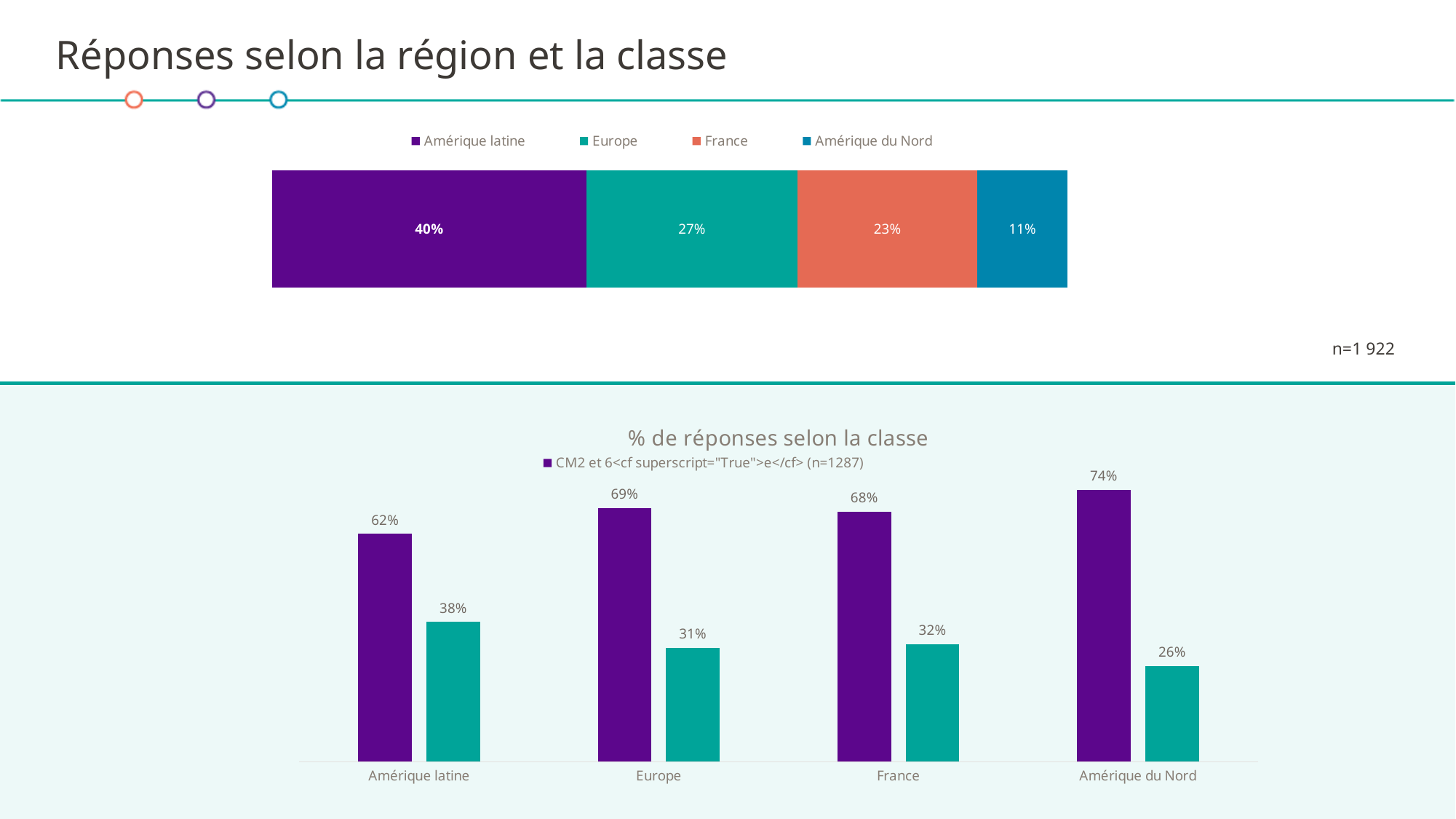
What kind of chart is the chart titled '% de réponses selon la classe'? Bar chart In the top stacked bar chart, which region has the largest segment? Amérique latine In the top stacked bar chart, which region has the smallest segment? Amérique du Nord In the chart titled '% de réponses selon la classe', which category has the lowest teal bar? Amérique du Nord In the top stacked bar chart, what is the difference between the Europe and France values? 4% In the chart titled '% de réponses selon la classe', which category has the highest purple bar? Amérique du Nord In the top stacked bar chart, what is the value for Amérique du Nord? 11% How many regions does the legend of the top stacked bar chart list? 4 In the top stacked bar chart, what is the value for Amérique latine? 40% In the chart titled '% de réponses selon la classe', what is the difference between the purple and teal bars for France? 36% In the chart titled '% de réponses selon la classe', what is the value of the teal bar for Europe? 31% In the chart titled '% de réponses selon la classe', what is the value of the purple bar for Amérique du Nord? 74%